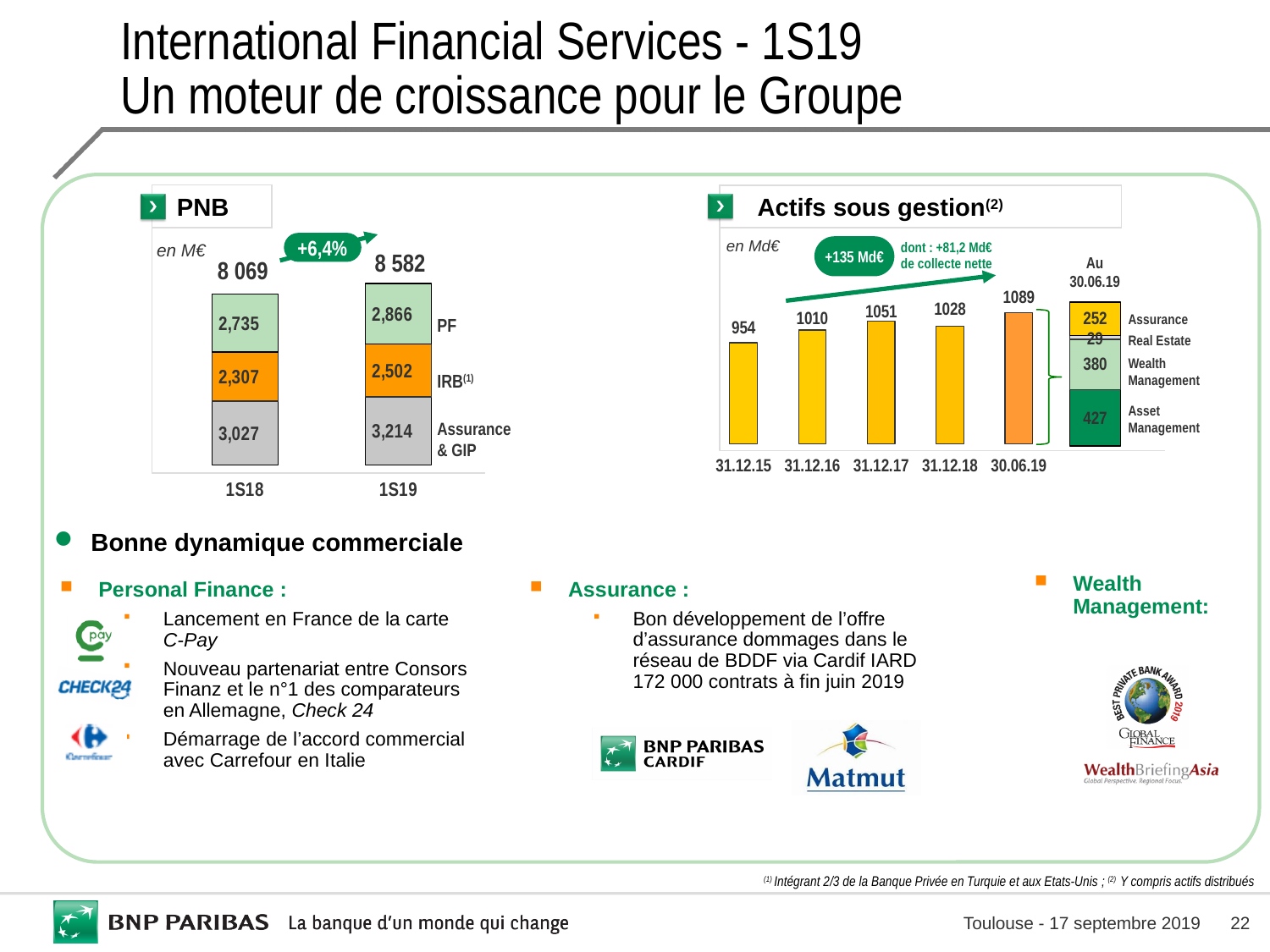
In the PNB chart, what is the value of the PF segment for 1S19? 2,866 In the PNB chart, which segment is the largest in 1S19? Assurance & GIP In the Actifs sous gestion chart, which is larger: the value at 31.12.17 or at 31.12.18? 31.12.17 In the Actifs sous gestion chart, how many dated bars are plotted along the x axis? 5 In the PNB chart, what is the value of the Assurance & GIP segment for 1S18? 3,027 In the Actifs sous gestion chart, what is the difference between the Wealth Management and Assurance amounts at 30.06.19? 128 In the Actifs sous gestion chart, what is the value at 31.12.17? 1051 In the PNB chart, what growth percentage is shown between 1S18 and 1S19? +6,4% In the Actifs sous gestion chart, which date has the lowest value? 31.12.15 In the PNB chart, what is the difference between the IRB segment in 1S19 and in 1S18? 195 In the PNB chart, what is the total PNB for 1S19? 8 582 In the Actifs sous gestion chart, what is the Asset Management amount in the breakdown at 30.06.19? 427